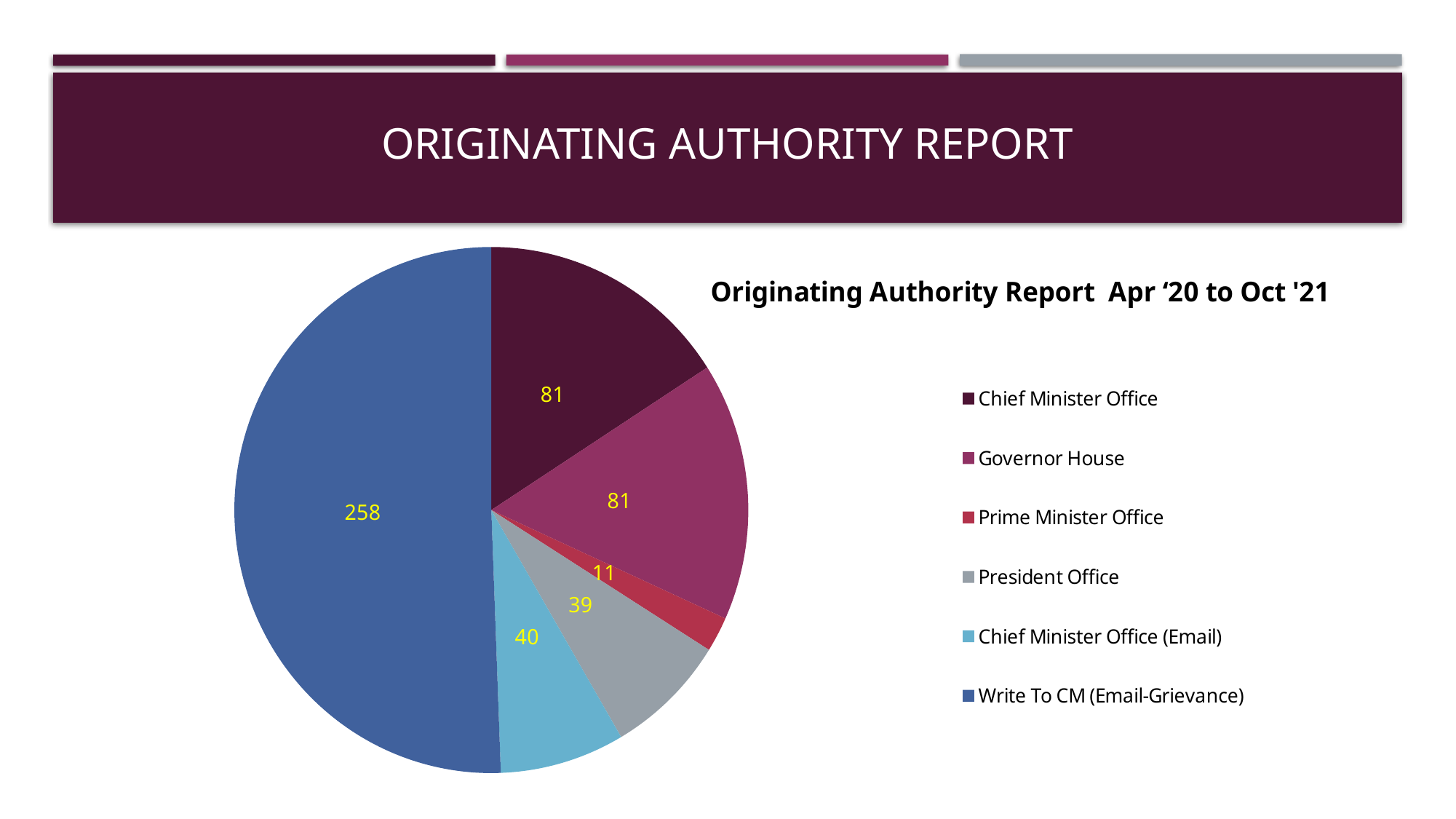
How many categories does the pie chart show? 6 Which category has the smallest slice in the pie chart? Prime Minister Office What is the value for Write To CM (Email-Grievance) in the pie chart? 258 What is the title of the chart on the slide? Originating Authority Report Apr '20 to Oct '21 What kind of chart is shown on the slide? Pie chart What is the value for Prime Minister Office in the pie chart? 11 What is the difference between the values for Write To CM (Email-Grievance) and Governor House? 177 Which category has the largest slice in the pie chart? Write To CM (Email-Grievance) What is the total of all the values shown in the pie chart? 510 What is the value for President Office in the pie chart? 39 Which is larger, the value for Governor House or the value for President Office? Governor House What is the value for Chief Minister Office (Email) in the pie chart? 40